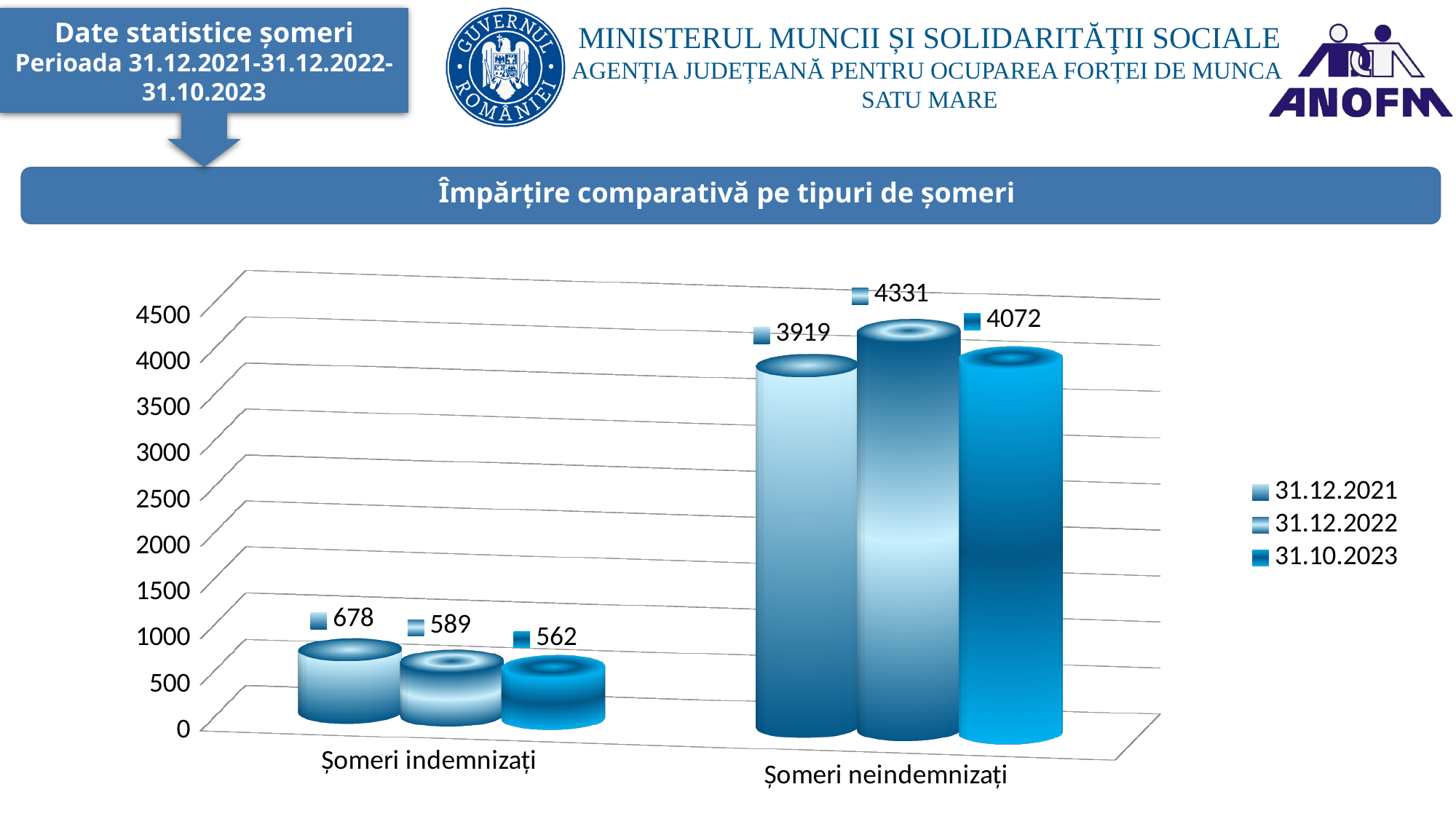
What is the value for Șomeri neindemnizați on 31.12.2022? 4331 What is the value for Șomeri neindemnizați on 31.10.2023? 4072 How many series does the legend list? 3 What kind of chart is shown? bar chart Do the values for Șomeri indemnizați rise or fall from 31.12.2021 to 31.10.2023? fall What is the value for Șomeri indemnizați on 31.12.2021? 678 Which date has the highest value for Șomeri neindemnizați? 31.12.2022 What is the value for Șomeri indemnizați on 31.10.2023? 562 How many categories are shown on the x axis? 2 Which date has the lowest value for Șomeri indemnizați? 31.10.2023 What is the difference between the 31.12.2022 and 31.12.2021 values for Șomeri neindemnizați? 412 Which is larger: Șomeri indemnizați on 31.12.2021 or on 31.12.2022? 31.12.2021